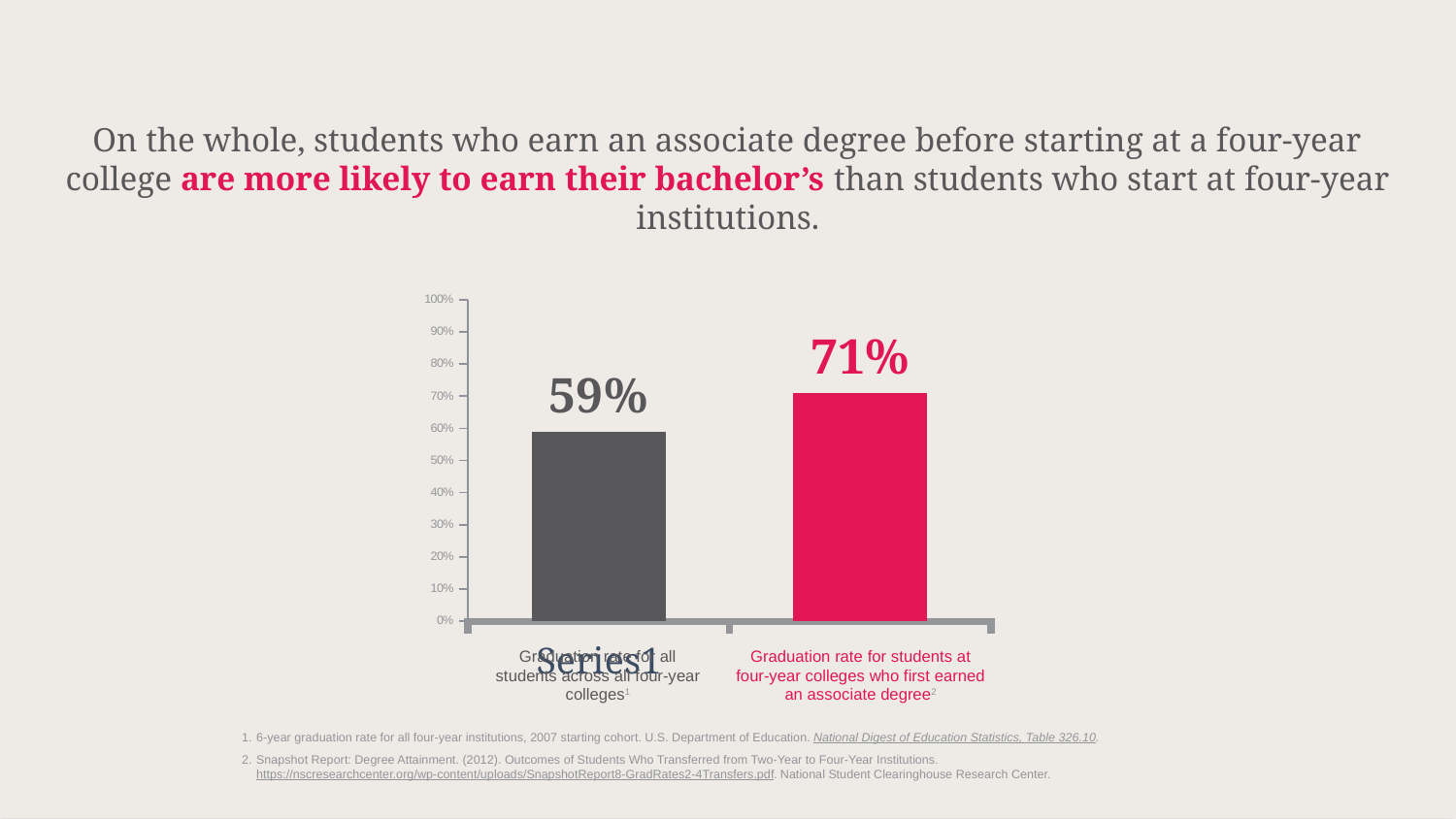
What is the graduation rate for all students across all four-year colleges? 59% What is the highest value shown on the chart's vertical axis? 100% How many bars are plotted in the chart? 2 Is the graduation rate for all students across all four-year colleges greater or less than 60%? less Which category has the lower graduation rate? Graduation rate for all students across all four-year colleges What colour is the bar for students who first earned an associate degree? red Is the graduation rate for students who first earned an associate degree greater or less than 70%? greater Is the graduation rate for students who first earned an associate degree larger or smaller than the rate for all students across all four-year colleges? larger Which category has the higher graduation rate? Graduation rate for students at four-year colleges who first earned an associate degree What is the graduation rate for students at four-year colleges who first earned an associate degree? 71% What kind of chart is shown on the slide? bar chart What is the difference in percentage points between the graduation rate for students who first earned an associate degree and the rate for all students across all four-year colleges? 12 percentage points